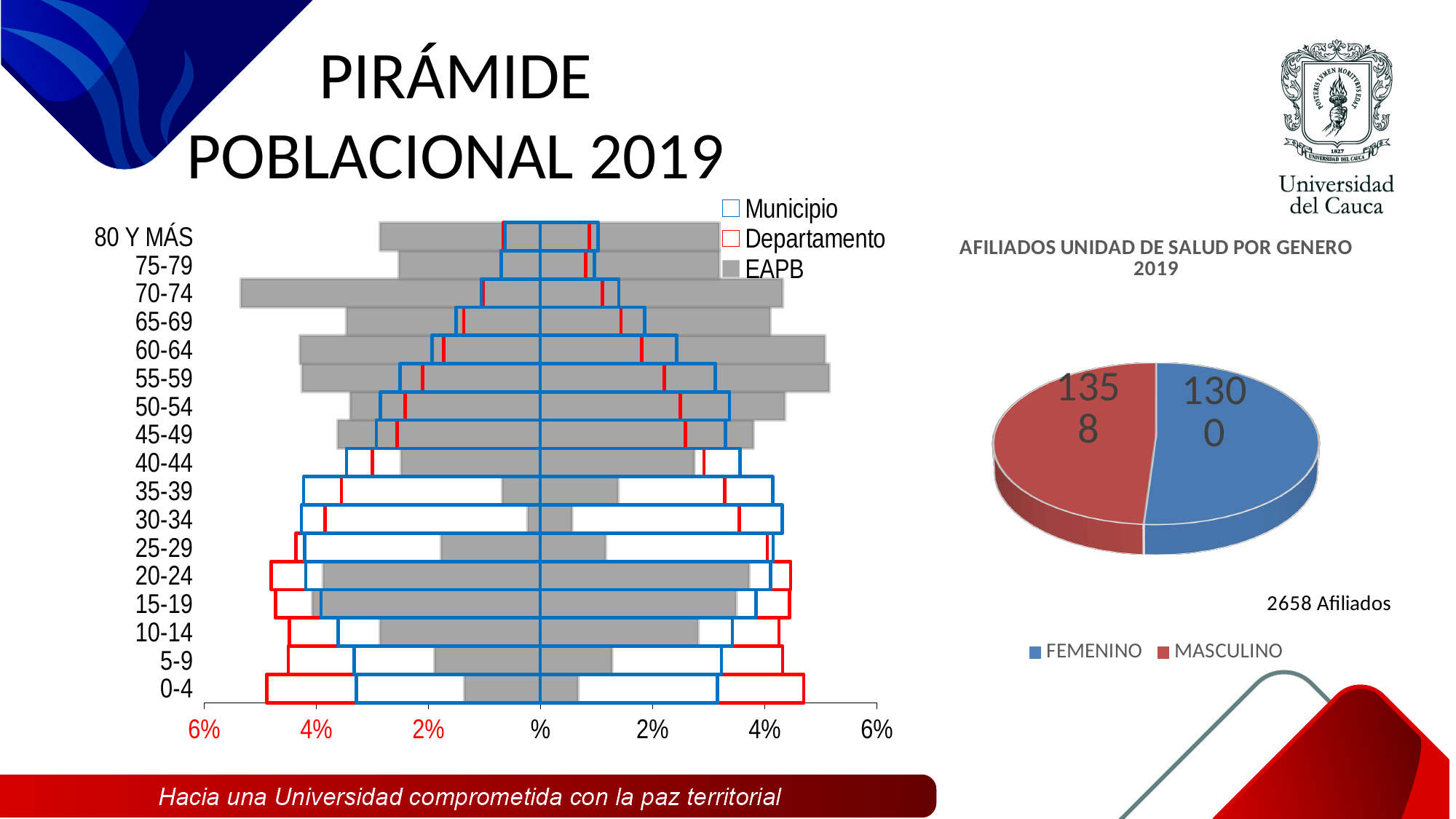
On the pie chart 'AFILIADOS UNIDAD DE SALUD POR GENERO 2019', what is the difference between the MASCULINO and FEMENINO values? 58 How many age groups are shown on the chart 'PIRÁMIDE POBLACIONAL 2019'? 17 On the pie chart 'AFILIADOS UNIDAD DE SALUD POR GENERO 2019', what is the value for FEMENINO? 1300 On the pie chart 'AFILIADOS UNIDAD DE SALUD POR GENERO 2019', what is the total number of afiliados? 2658 What kind of chart is 'AFILIADOS UNIDAD DE SALUD POR GENERO 2019'? Pie chart What kind of chart is 'PIRÁMIDE POBLACIONAL 2019'? Bar chart On the pie chart 'AFILIADOS UNIDAD DE SALUD POR GENERO 2019', what is the value for MASCULINO? 1358 On the chart 'PIRÁMIDE POBLACIONAL 2019', is the EAPB value for the 0-4 age group on the left side greater or less than 2%? less On the chart 'PIRÁMIDE POBLACIONAL 2019', which colour represents the EAPB series? Gray How many series does the legend of the chart 'PIRÁMIDE POBLACIONAL 2019' list? 3 How many series does the legend of the pie chart 'AFILIADOS UNIDAD DE SALUD POR GENERO 2019' list? 2